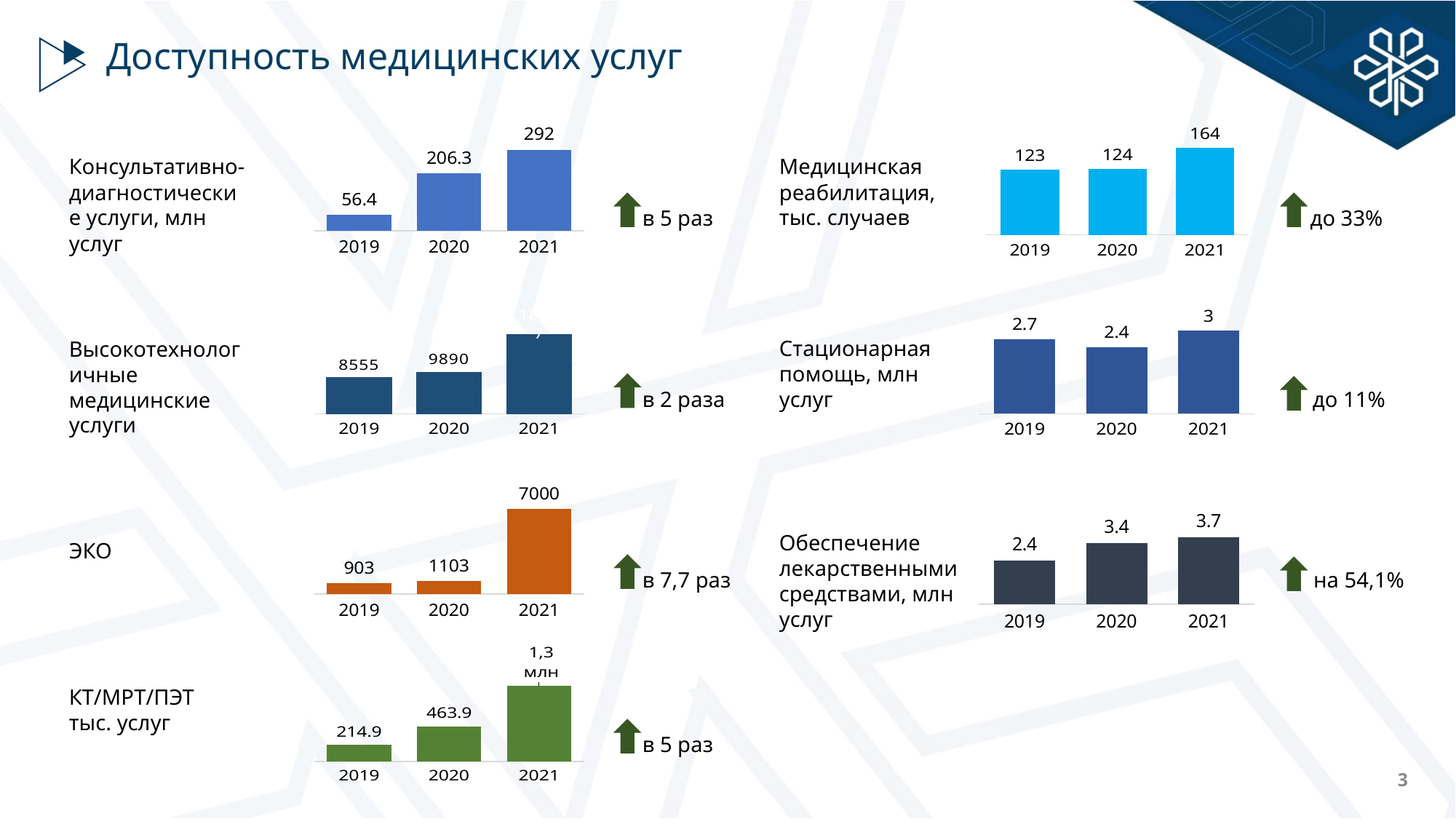
How many years (categories) are shown in the chart for Медицинская реабилитация? 3 In the chart for Медицинская реабилитация, which year has the highest value? 2021 In the chart for Стационарная помощь, which year has the lowest value? 2020 In the chart for Обеспечение лекарственными средствами, what is the value for 2020? 3.4 In the chart for Консультативно-диагностические услуги, what is the value for 2019? 56.4 In the chart for Высокотехнологичные медицинские услуги, which is larger, the value for 2019 or for 2020? 2020 In the КТ/МРТ/ПЭТ chart, what is the value for 2020? 463.9 In the ЭКО chart, what is the value for 2021? 7000 In the chart for Консультативно-диагностические услуги, what is the value for 2021? 292 In the chart for Обеспечение лекарственными средствами, do the values rise or fall from 2019 to 2021? rise What type of chart is used for Обеспечение лекарственными средствами? bar chart In the ЭКО chart, what is the difference between the 2020 and 2019 values? 200